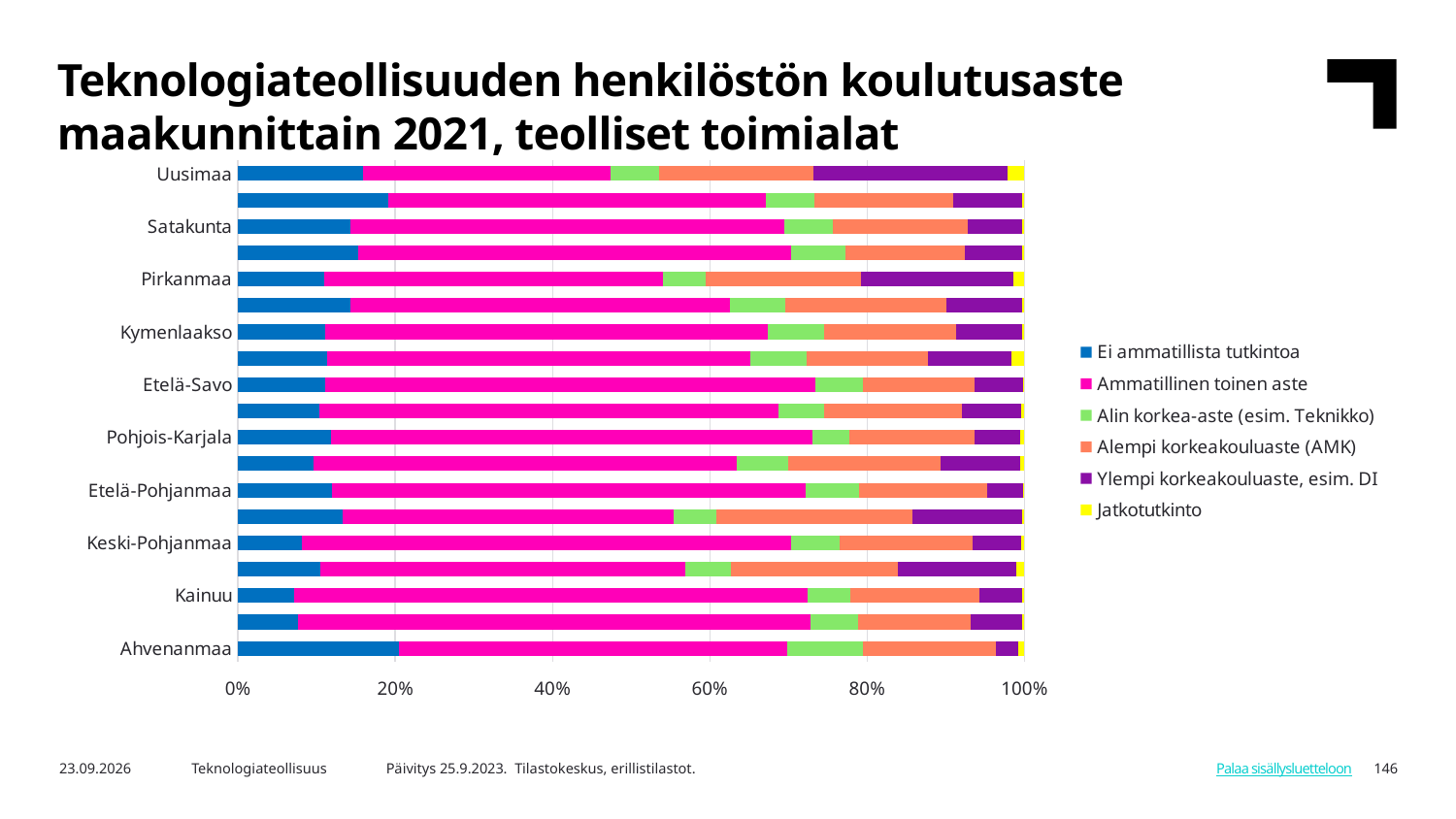
Which legend entry is shown in yellow? Jatkotutkinto How many series does the legend list? 6 Is the 'Ammatillinen toinen aste' share for Kainuu greater or less than 60%? greater Which has the larger 'Ei ammatillista tutkintoa' share, Ahvenanmaa or Kainuu? Ahvenanmaa How many bars (regions) are plotted in the chart? 19 Is the 'Ei ammatillista tutkintoa' share for Pirkanmaa greater or less than 20%? less What is the title of the chart on the slide? Teknologiateollisuuden henkilöstön koulutusaste maakunnittain 2021, teolliset toimialat What kind of chart is shown on the slide? Stacked bar chart Is the 'Ammatillinen toinen aste' share for Uusimaa greater or less than 40%? less Which has the larger 'Ammatillinen toinen aste' share, Kainuu or Uusimaa? Kainuu Which region has the largest 'Ylempi korkeakouluaste, esim. DI' share? Uusimaa